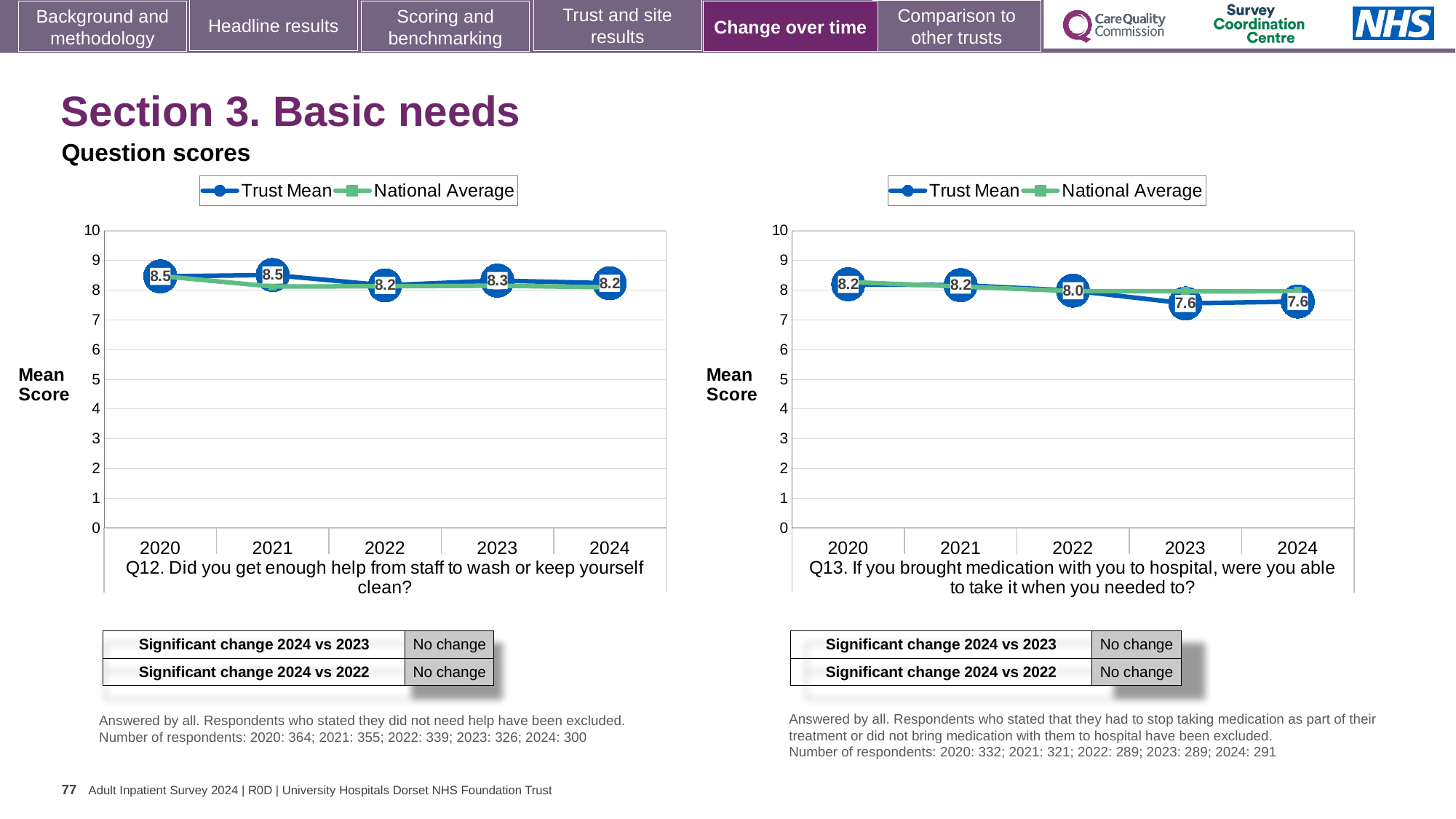
In the Q13 chart (right), how many series does the legend list? 2 In the Q13 chart (right), what is the Trust Mean for 2024? 7.6 In the Q12 chart (left), what is the Trust Mean for 2020? 8.5 In the Q13 chart (right), does the Trust Mean generally rise or fall from 2020 to 2024? Fall In the Q12 chart (left), how many years are plotted on the x axis? 5 In the Q12 chart (left), what is the Trust Mean for 2024? 8.2 What type of chart is used for Q12 (left)? Line chart In the Q13 chart (right), what is the difference between the Trust Mean in 2020 and in 2024? 0.6 In the Q12 chart (left), what is the difference between the Trust Mean in 2020 and in 2024? 0.3 In the Q13 chart (right), which year has the lowest Trust Mean? 2023 and 2024 (both 7.6) In the Q13 chart (right), what is the Trust Mean for 2022? 8.0 In the Q13 chart (right), is the Trust Mean for 2023 greater or less than 8? less